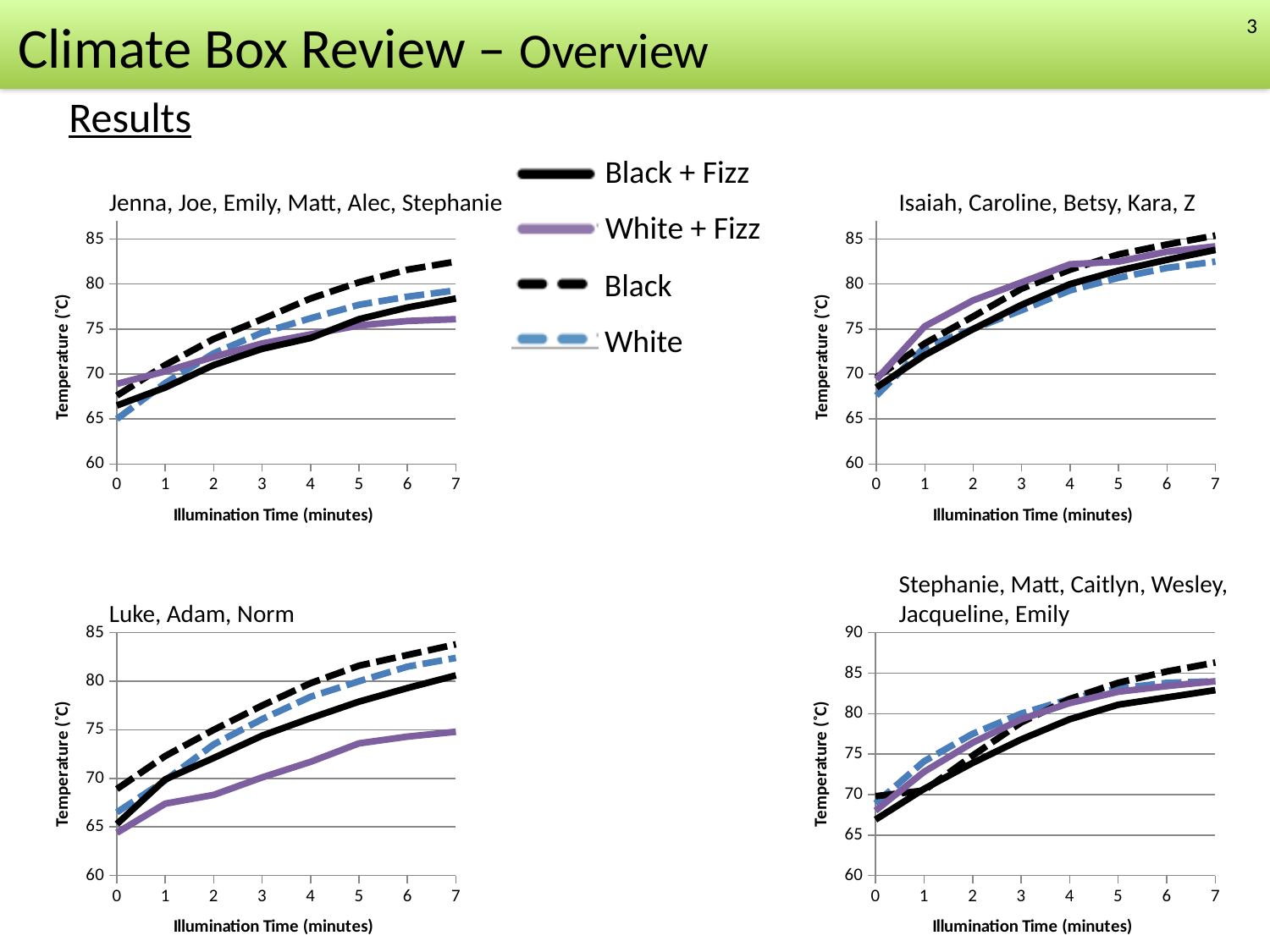
How many charts are shown on the slide? 4 What kind of chart is the 'Luke, Adam, Norm' chart? line chart In the 'Jenna, Joe, Emily, Matt, Alec, Stephanie' chart, which series has the highest temperature at 7 minutes? Black In the 'Luke, Adam, Norm' chart, is the value for White + Fizz at 7 minutes greater or less than 80? less In the 'Isaiah, Caroline, Betsy, Kara, Z' chart, is the value for White at 0 minutes greater or less than 70? less How many series does the shared legend list for the charts? 4 In the 'Luke, Adam, Norm' chart, which series has the lowest temperature at 7 minutes? White + Fizz In the 'Jenna, Joe, Emily, Matt, Alec, Stephanie' chart, is the value for Black at 7 minutes greater or less than 80? greater In the 'Luke, Adam, Norm' chart, which is larger at 7 minutes, Black + Fizz or White + Fizz? Black + Fizz What is the x-axis label on the 'Isaiah, Caroline, Betsy, Kara, Z' chart? Illumination Time (minutes) What is the y-axis label on the 'Stephanie, Matt, Caitlyn, Wesley, Jacqueline, Emily' chart? Temperature (°C) In the 'Luke, Adam, Norm' chart, does the Black series rise or fall as illumination time increases? rise